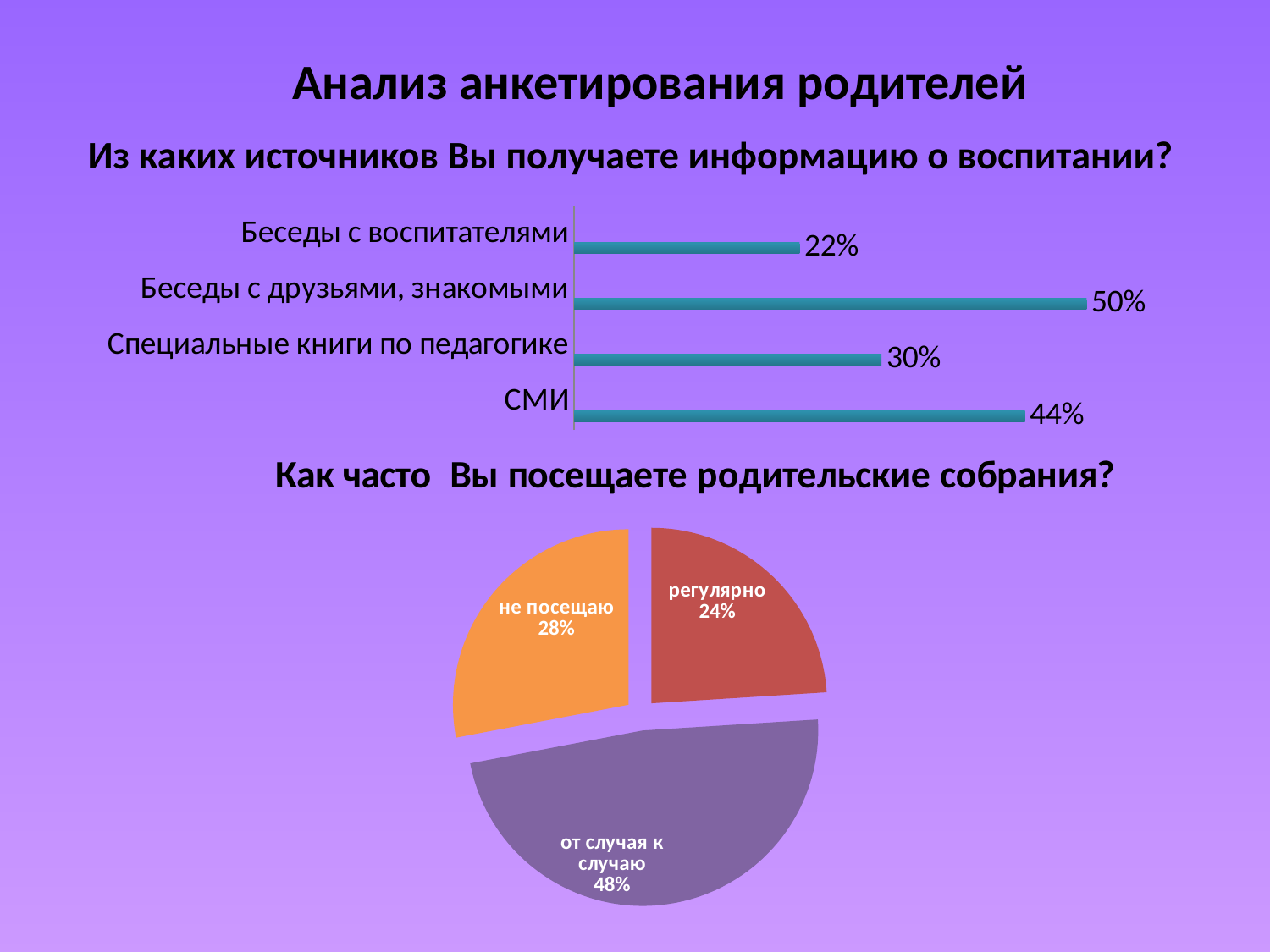
In the bar chart about sources of information on upbringing, which category has the highest value? Беседы с друзьями, знакомыми What kind of chart is the top chart on the slide? bar chart In the bar chart about sources of information on upbringing, which is larger: 'СМИ' or 'Специальные книги по педагогике'? СМИ How many categories does the bar chart about sources of information on upbringing show? 4 In the bar chart about sources of information on upbringing, what is the value for 'Беседы с воспитателями'? 22% In the pie chart about attending parent meetings, what share is 'регулярно'? 24% In the pie chart about attending parent meetings, which slice is the smallest? регулярно In the bar chart about sources of information on upbringing, which category has the lowest value? Беседы с воспитателями In the bar chart about sources of information on upbringing, what is the difference between 'Беседы с друзьями, знакомыми' and 'Специальные книги по педагогике'? 20% In the pie chart about attending parent meetings, what share is 'от случая к случаю'? 48% In the bar chart about sources of information on upbringing, what is the value for 'СМИ'? 44% What kind of chart is the bottom chart on the slide? pie chart